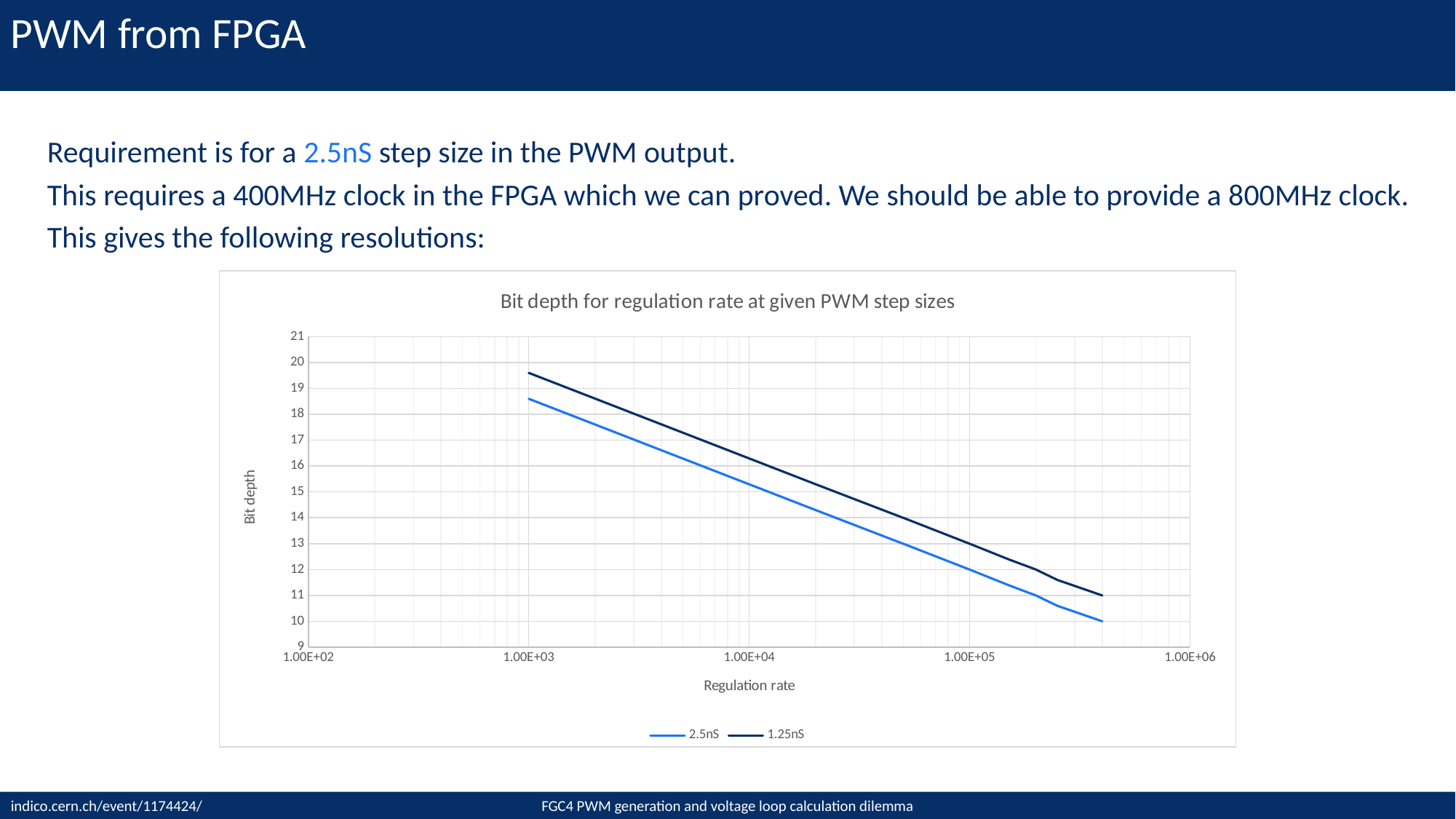
Which series has the lower bit depth across the plotted range? 2.5nS How many series does the chart legend list? 2 Is the bit depth for the 1.25nS series at a regulation rate of 1.00E+03 greater or less than 21? less Is the bit depth for the 1.25nS series at a regulation rate of 1.00E+05 greater or less than 14? less What is the bit depth at the right-hand end of the 2.5nS line? 10 What kind of chart is shown on the slide? line chart Which series has the higher bit depth at a regulation rate of 1.00E+04, 2.5nS or 1.25nS? 1.25nS Does the bit depth rise or fall as the regulation rate increases along the x axis? fall What is the title of the chart? Bit depth for regulation rate at given PWM step sizes What is the label of the y axis of the chart? Bit depth Is the bit depth for the 2.5nS series at a regulation rate of 1.00E+04 greater or less than 14? greater What is the bit depth at the right-hand end of the 1.25nS line? 11